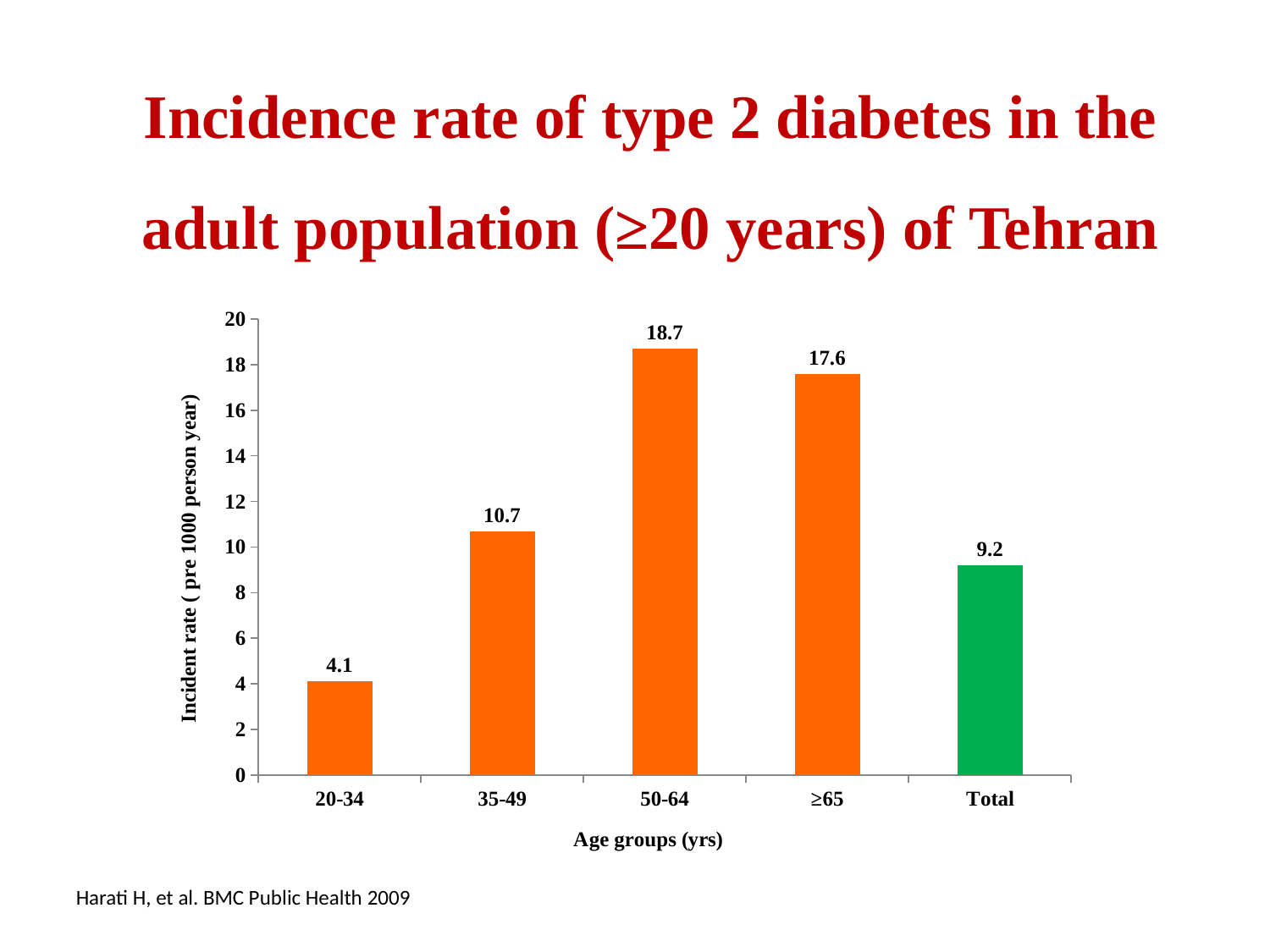
What is the incidence rate for the 35-49 age group? 10.7 What is the label of the x axis? Age groups (yrs) What is the incidence rate for the ≥65 age group? 17.6 What is the incidence rate for the 20-34 age group? 4.1 What is the difference between the incidence rates of the 50-64 and 35-49 age groups? 8 Which age group has the lowest incidence rate? 20-34 Which has a higher incidence rate, the 35-49 age group or the Total? 35-49 How many bars are shown in the chart? 5 Which age group has the highest incidence rate? 50-64 What is the incidence rate shown for the Total bar? 9.2 What kind of chart is shown on the slide? Bar chart Is the value for the ≥65 age group greater or less than 16? greater